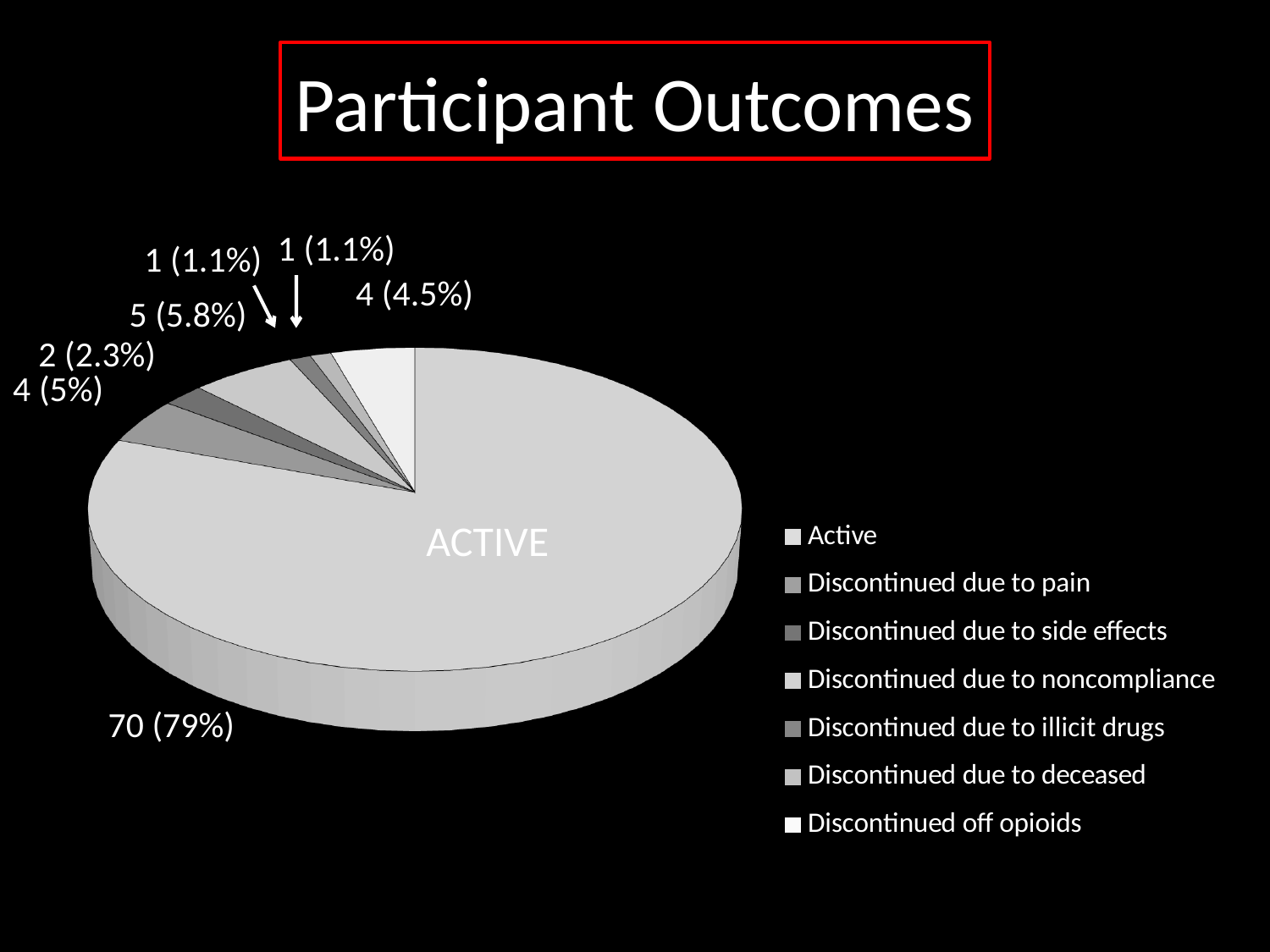
What share of the pie does the Active slice represent? 79% What is the smallest data label value shown on the pie chart? 1 (1.1%) Is the share of the Active slice greater or less than 50%? greater Which is larger: the slice labeled 5 (5.8%) or the slice labeled 2 (2.3%)? 5 (5.8%) How many participants are in the Active category? 70 How many categories does the legend of the pie chart list? 7 What kind of chart is shown on the slide? Pie chart What is the data label shown for the Active slice of the pie chart? 70 (79%) What is the title of the chart on the slide? Participant Outcomes How many slices of the pie chart are labeled 1 (1.1%)? 2 Which category has the largest slice in the pie chart? Active What is the last entry listed in the legend of the pie chart? Discontinued off opioids